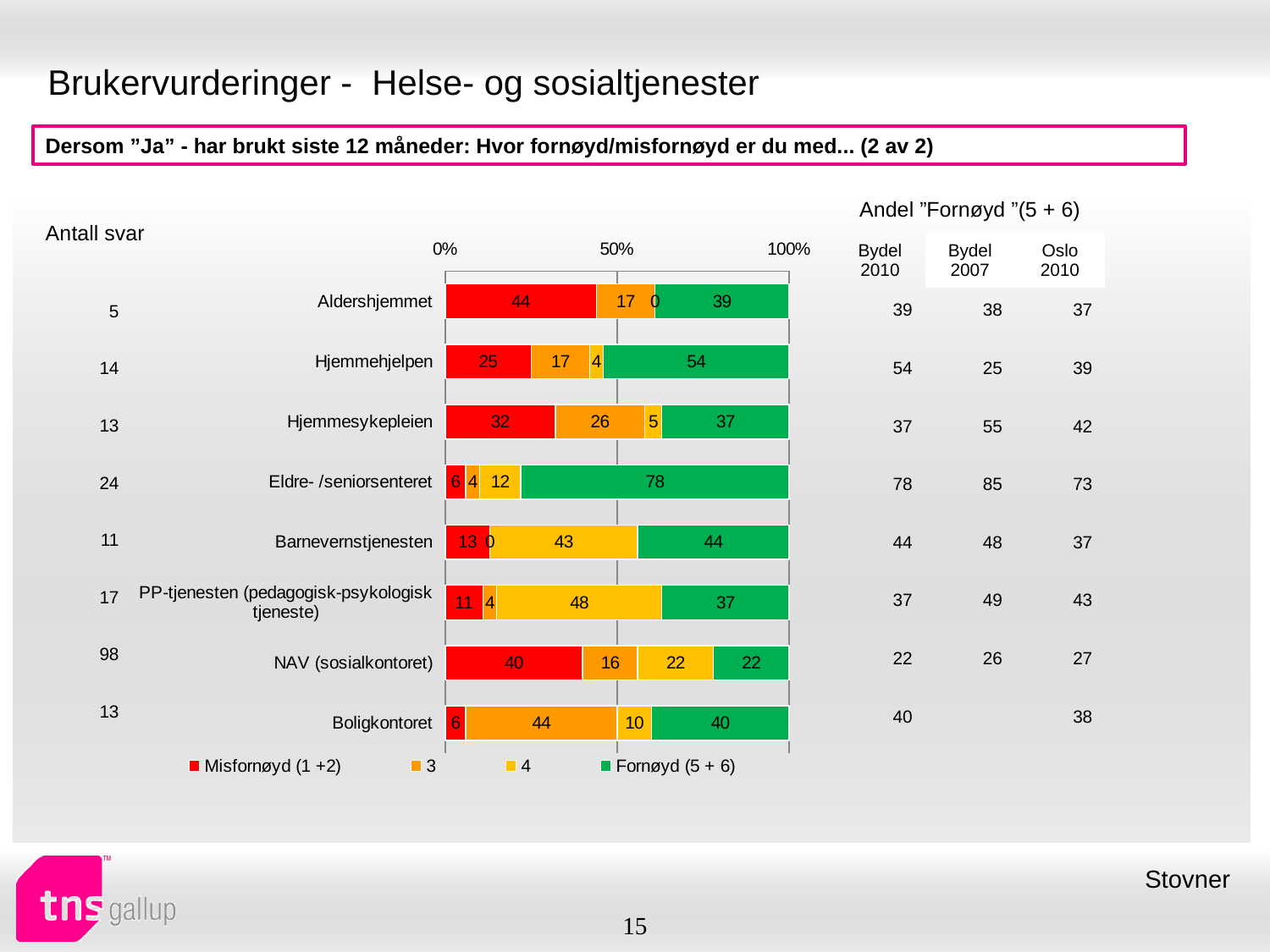
What is the value of "Misfornøyd (1 +2)" for NAV (sosialkontoret)? 40 Which category has the highest "Fornøyd (5 + 6)" value? Eldre- /seniorsenteret What is the value of "Fornøyd (5 + 6)" for Eldre- /seniorsenteret? 78 What is the difference between the "Fornøyd (5 + 6)" values for Hjemmehjelpen and Hjemmesykepleien? 17 Which has a larger "Misfornøyd (1 +2)" value, Aldershjemmet or Hjemmehjelpen? Aldershjemmet Which colour represents "Fornøyd (5 + 6)" in the chart? green What kind of chart is shown on the slide? stacked bar chart How many categories (services) are plotted in the chart? 8 What is the total of the stacked bar for Aldershjemmet? 100 Which category has the lowest "Fornøyd (5 + 6)" value? NAV (sosialkontoret) What is the value of series "3" for Boligkontoret? 44 How many series does the chart legend list? 4